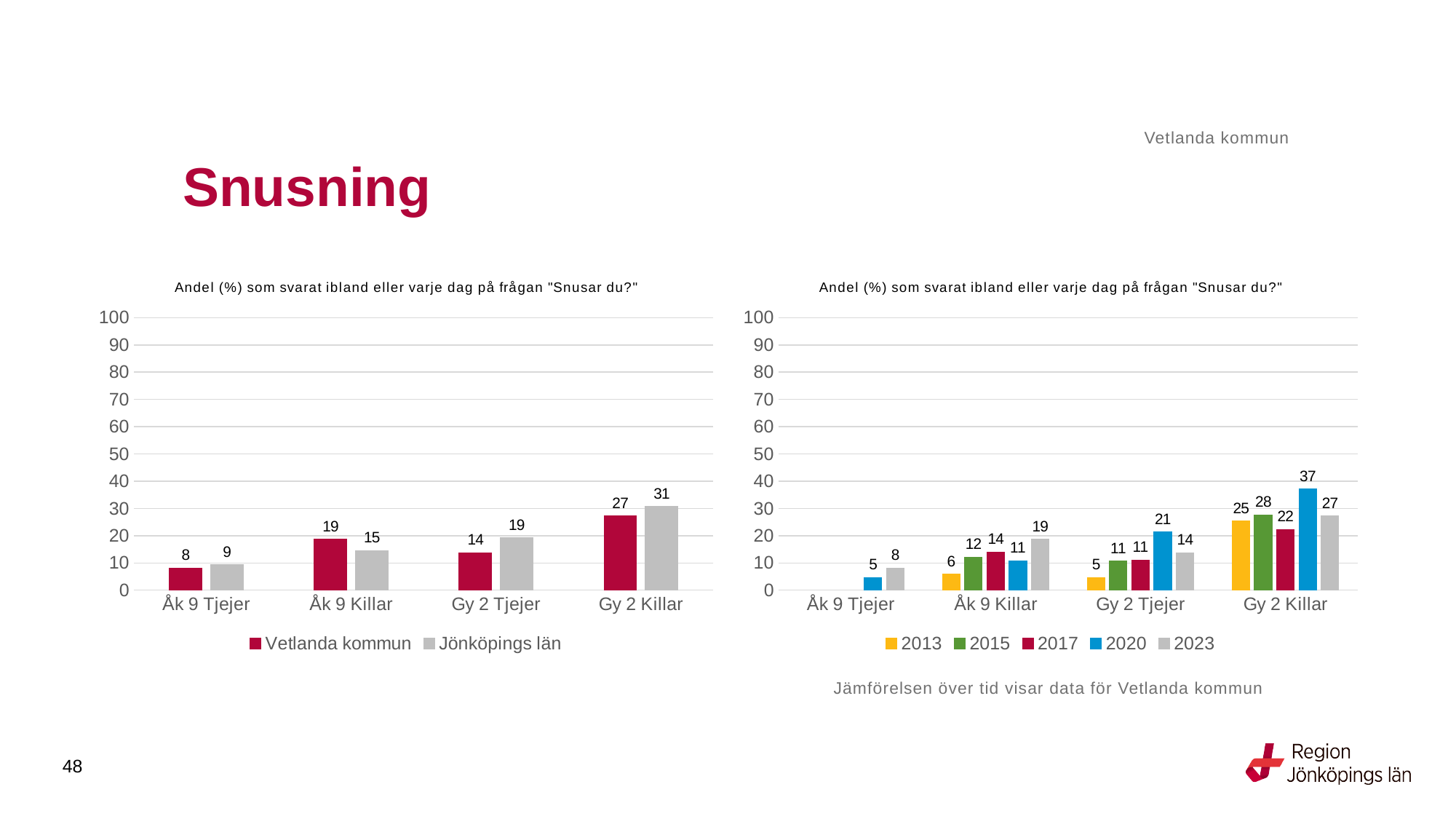
In the left chart, what is the value for Vetlanda kommun for Gy 2 Killar? 27 In the right chart, how many series does the legend list? 5 In the left chart, what is the difference between Jönköpings län and Vetlanda kommun for Gy 2 Tjejer? 5 In the right chart, what is the value for 2013 for Åk 9 Killar? 6 In the left chart, how many series does the legend list? 2 In the left chart, which is larger for Åk 9 Killar: Vetlanda kommun or Jönköpings län? Vetlanda kommun In the right chart, what is the value for 2020 for Gy 2 Killar? 37 In the right chart, what is the difference between the 2020 and 2023 values for Gy 2 Tjejer? 7 In the right chart, which year has the lowest value for Gy 2 Tjejer? 2013 In the left chart, what is the value for Jönköpings län for Åk 9 Killar? 15 What kind of chart is the right chart? Bar chart In the left chart, which category has the highest value for Jönköpings län? Gy 2 Killar